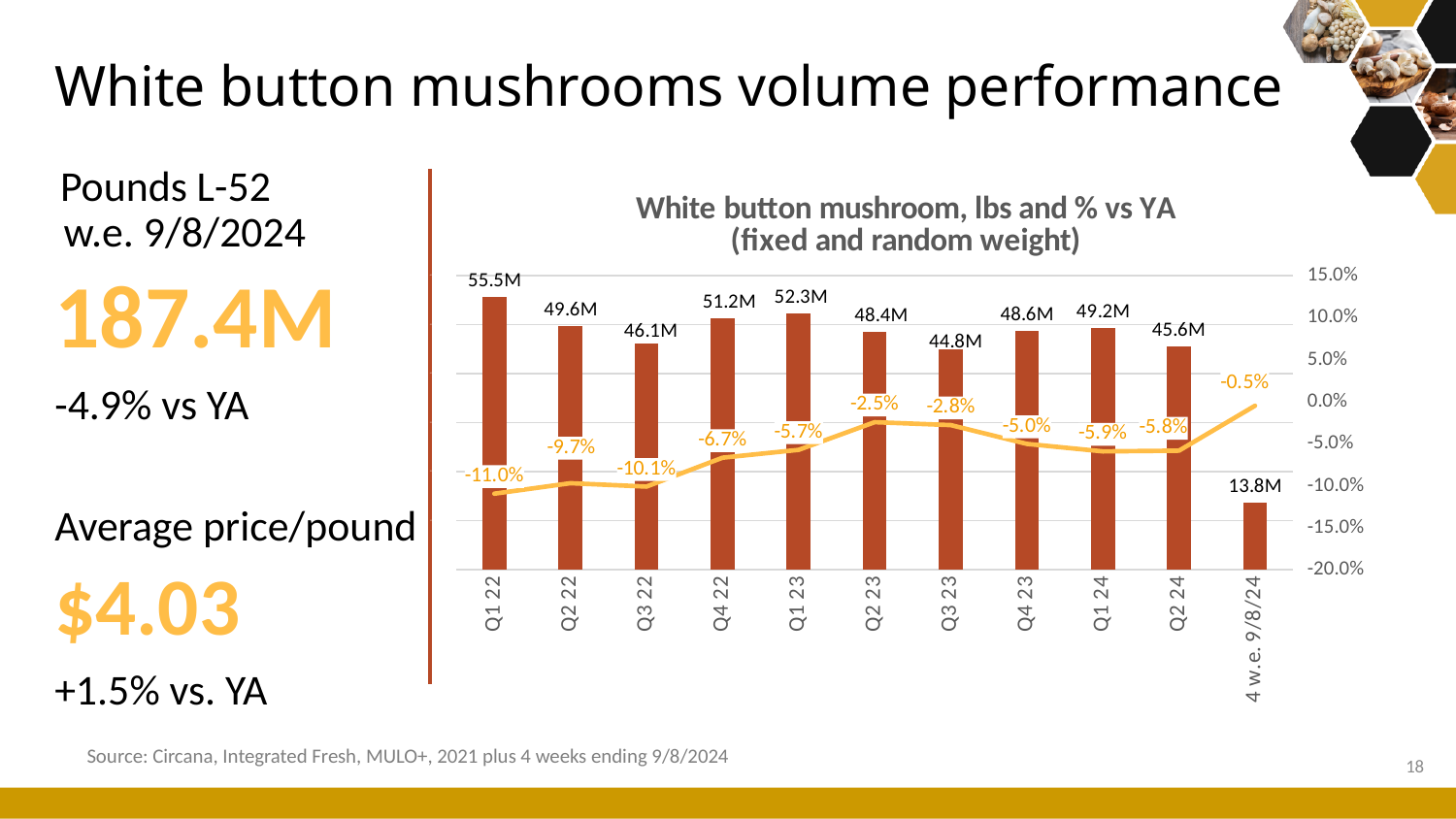
What is the title of the chart? White button mushroom, lbs and % vs YA (fixed and random weight) How many periods are shown on the x axis? 11 Which quarter has the lowest % vs YA value? Q1 22 Does the % vs YA line rise or fall from Q1 22 to Q2 23? Rise What is the lbs value for the 4 w.e. 9/8/24 period? 13.8M What kind of chart is this? Bar chart with a line What is the % vs YA value for Q2 23? -2.5% What is the difference in lbs between Q1 23 and Q2 23? 3.9M Which quarter has the highest lbs value? Q1 22 What is the % vs YA value for the 4 w.e. 9/8/24 period? -0.5% What is the lbs value for Q1 22? 55.5M Which is larger, the lbs value for Q4 22 or Q4 23? Q4 22